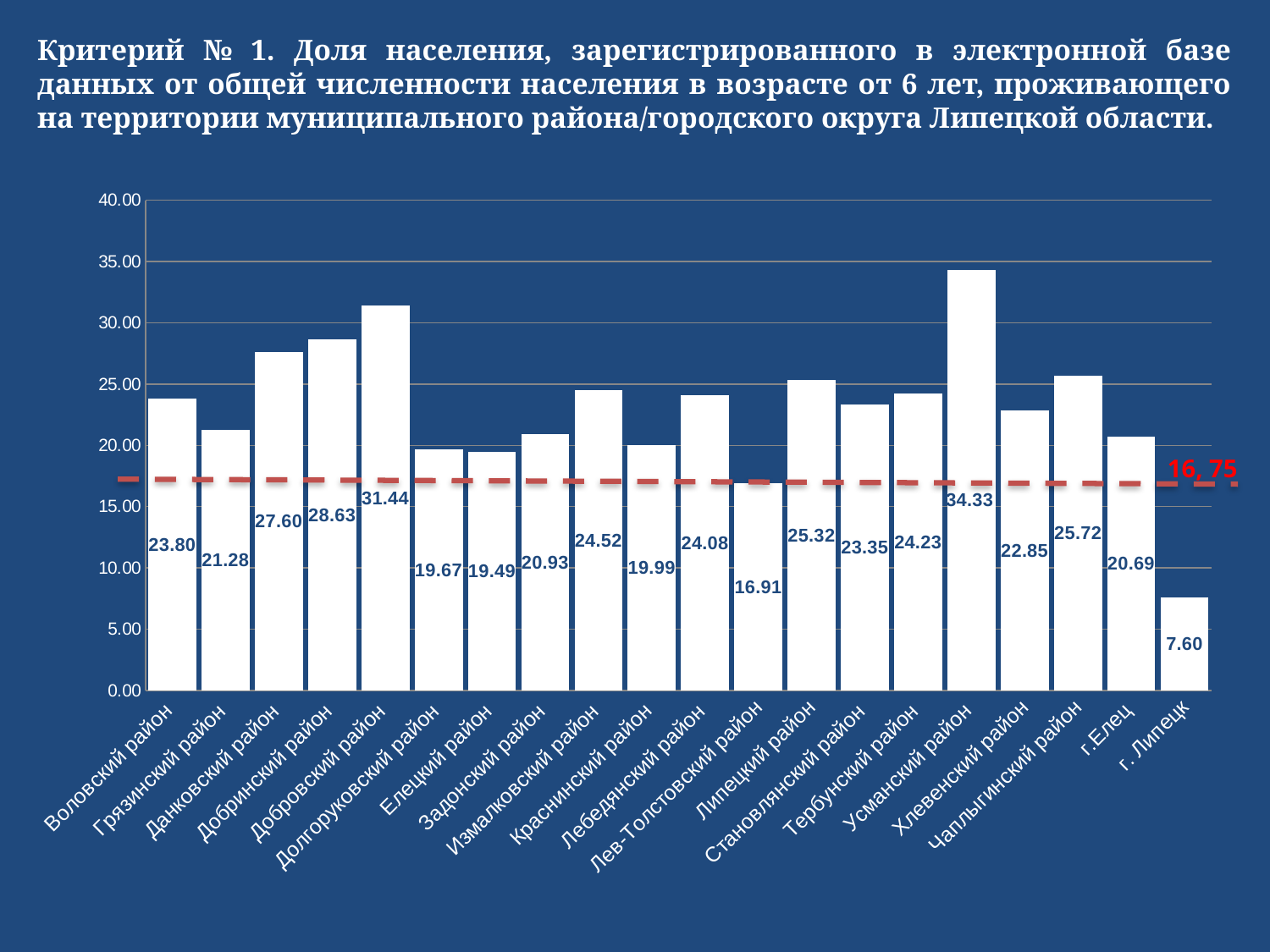
What is the value for Добровский район? 31.44 Which category has the lowest value? г. Липецк Which category has the highest value? Усманский район What is the value for г. Липецк? 7.60 How many categories are shown on the x axis? 20 What value is marked by the red dashed horizontal line? 16,75 What is the difference between the values for Усманский район and г. Липецк? 26.73 What kind of chart is shown on the slide? Bar chart What is the difference between the values for Добровский район and Данковский район? 3.84 What is the value for Усманский район? 34.33 Which is larger, the value for Липецкий район or the value for Становлянский район? Липецкий район What is the value for Лев-Толстовский район? 16.91